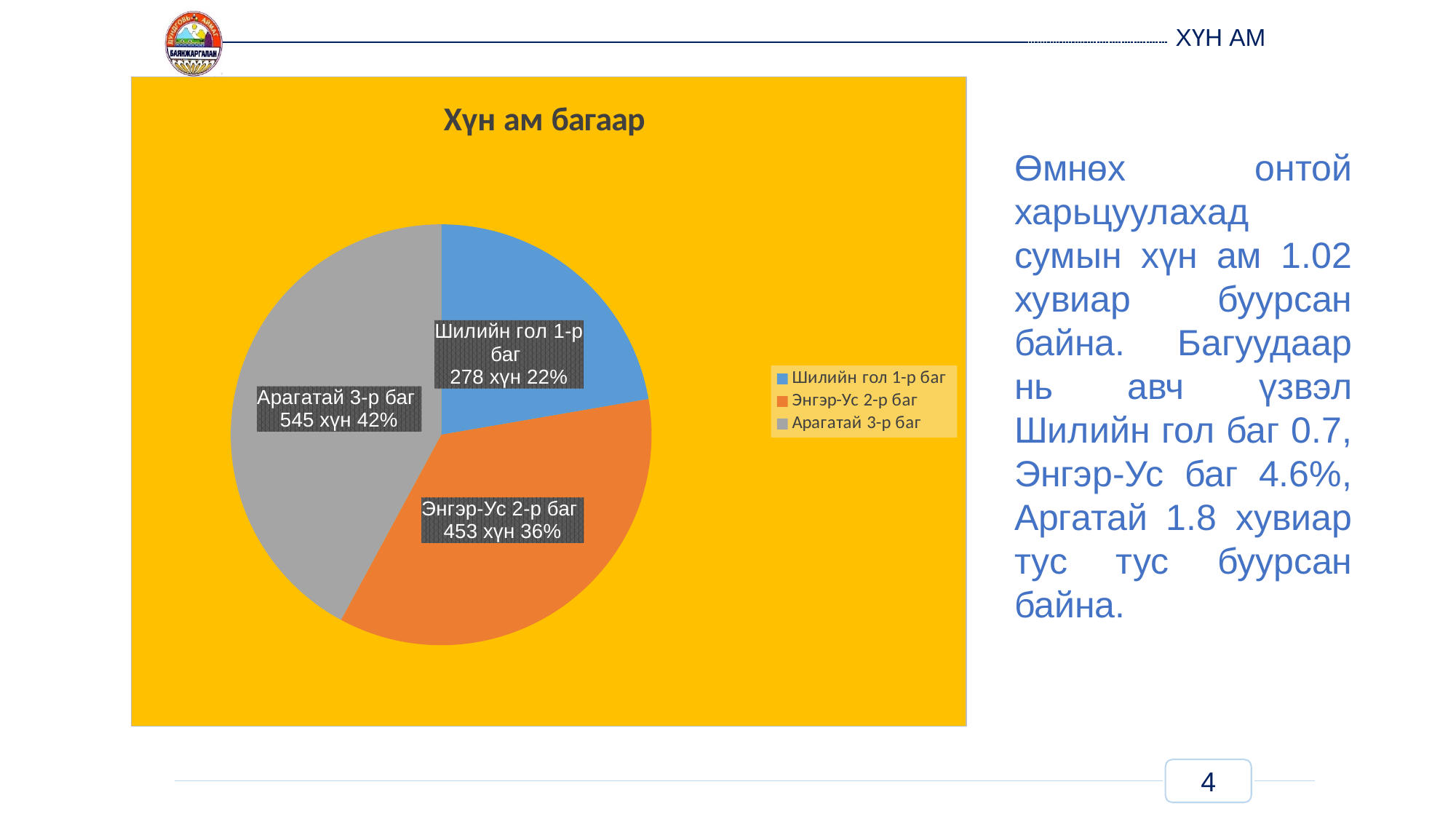
Which баг has the smallest population in the chart? Шилийн гол 1-р баг What share of the pie does Шилийн гол 1-р баг represent? 22% What is the population value shown for Энгэр-Ус 2-р баг? 453 хүн What kind of chart is shown on the slide? Pie chart How many entries does the legend list? 3 What is the title of the chart? Хүн ам багаар How many slices does the pie chart have? 3 Which баг has the largest population in the chart? Арагатай 3-р баг What is the population value shown for Арагатай 3-р баг? 545 хүн What is the difference in population between Арагатай 3-р баг and Энгэр-Ус 2-р баг? 92 хүн What is the population value shown for Шилийн гол 1-р баг? 278 хүн What share of the pie does Арагатай 3-р баг represent? 42%